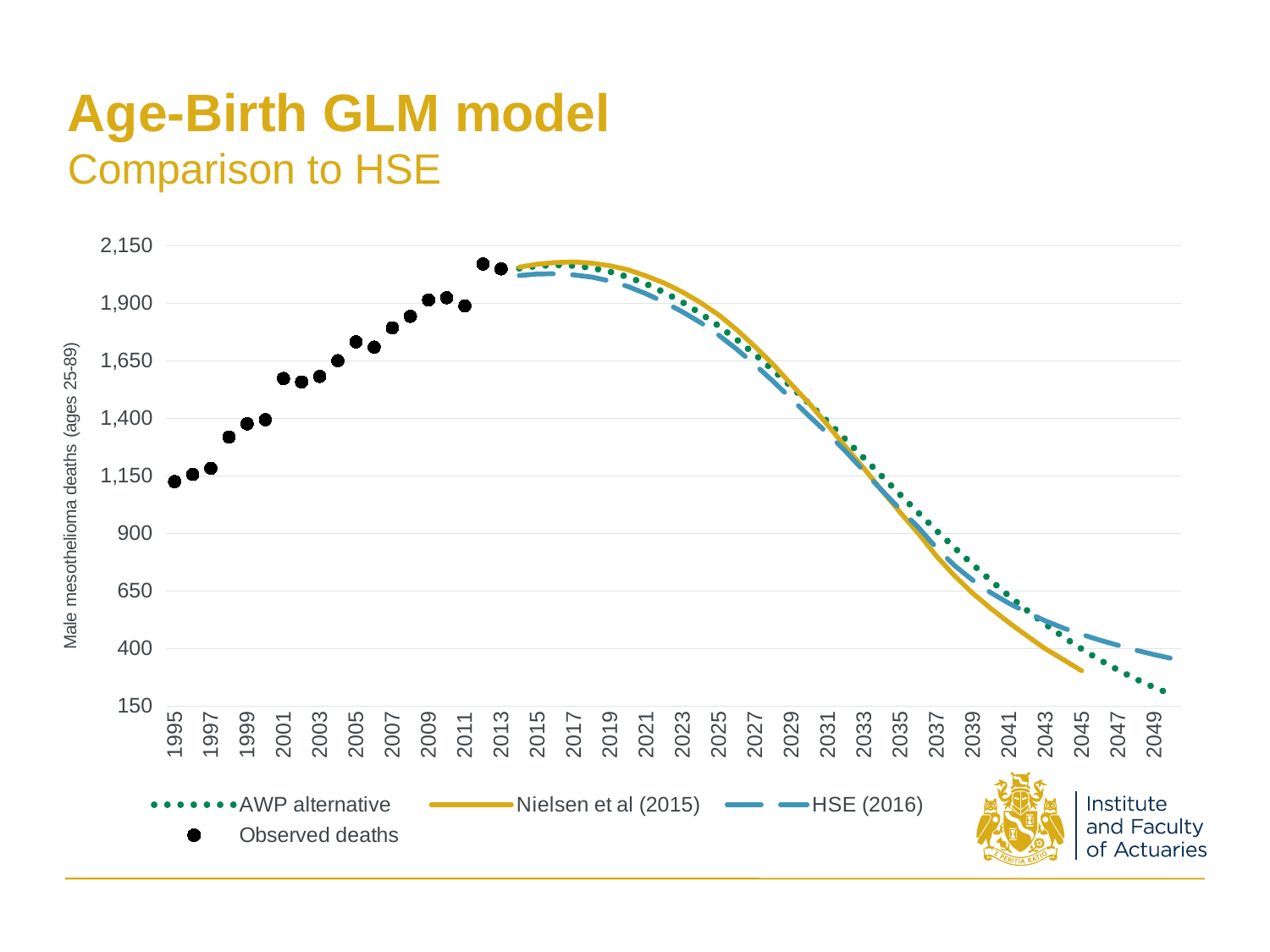
Which series is shown as black dots? Observed deaths Is the Nielsen et al (2015) value for 2045 greater or less than 400? less Is the AWP alternative value for 2049 greater or less than 400? less What is the label on the vertical axis? Male mesothelioma deaths (ages 25-89) Do the observed deaths rise or fall between 1995 and 2013? Rise What kind of chart is shown on the slide? Line chart Is the Nielsen et al (2015) value for 2025 greater or less than 1,650? greater Do the projected values for Nielsen et al (2015) rise or fall between 2025 and 2045? Fall In 2043, which is lower: Nielsen et al (2015) or HSE (2016)? Nielsen et al (2015) How many series does the legend list? 4 In 2049, which is higher: the AWP alternative or HSE (2016)? HSE (2016)